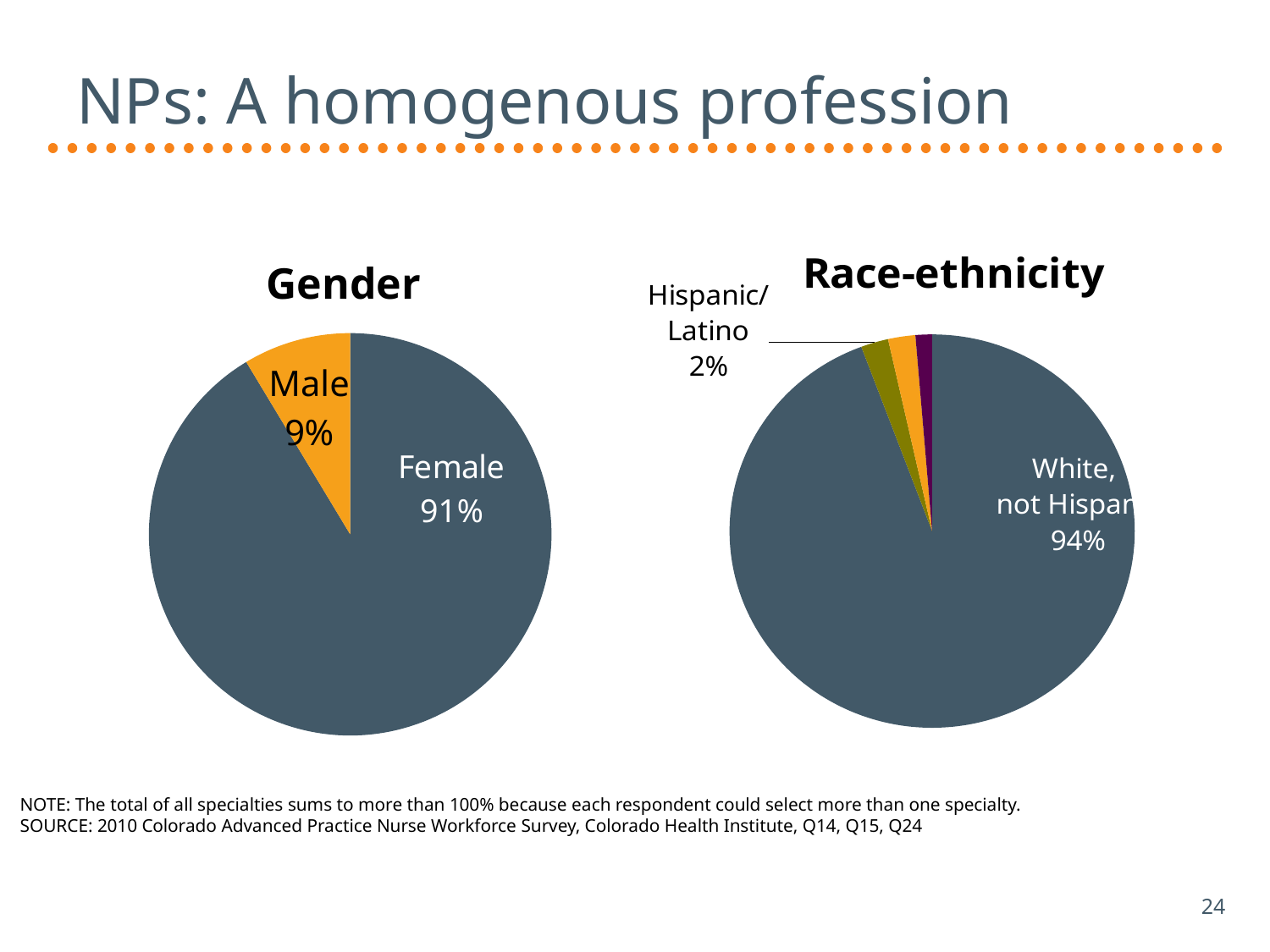
In the Gender pie chart, which category has the smallest share? Male In the Race-ethnicity pie chart, which category has the largest share? White, not Hispanic In the Gender pie chart, what percentage of NPs are male? 9% What is the title of the pie chart on the left of the slide? Gender In the Race-ethnicity pie chart, what percentage of NPs are White, not Hispanic? 94% In the Gender pie chart, what is the difference in percentage points between Female and Male? 82 percentage points In the Gender pie chart, which category has the largest share? Female In the Race-ethnicity pie chart, what percentage of NPs are Hispanic/Latino? 2% In the Gender pie chart, what percentage of NPs are female? 91% What kind of chart is the Gender chart? Pie chart In the Gender pie chart, how many slices are there? 2 In the Race-ethnicity pie chart, how many slices are there? 4